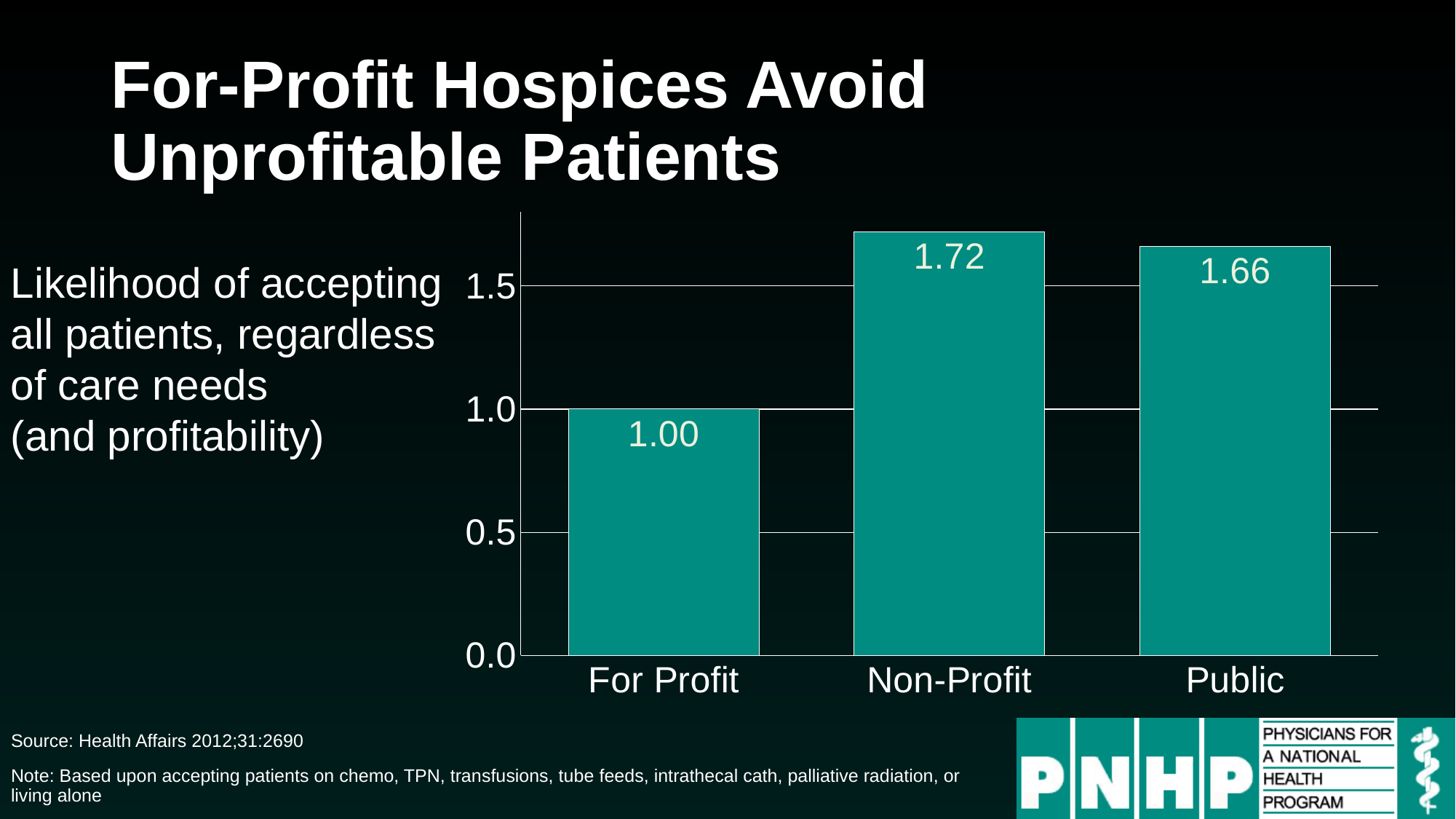
What is the value for Non-Profit? 1.72 Is the value for Public greater or less than 1.5? greater What is the difference between the values for Non-Profit and Public? 0.06 What is the value for Public? 1.66 What is the value for For Profit? 1.00 What is the title of the slide containing the chart? For-Profit Hospices Avoid Unprofitable Patients Which category has the lowest value? For Profit What is the difference between the values for Non-Profit and For Profit? 0.72 How many categories are shown on the x axis? 3 What kind of chart is shown on the slide? bar chart Which is larger, the value for Public or the value for For Profit? Public Which category has the highest value? Non-Profit